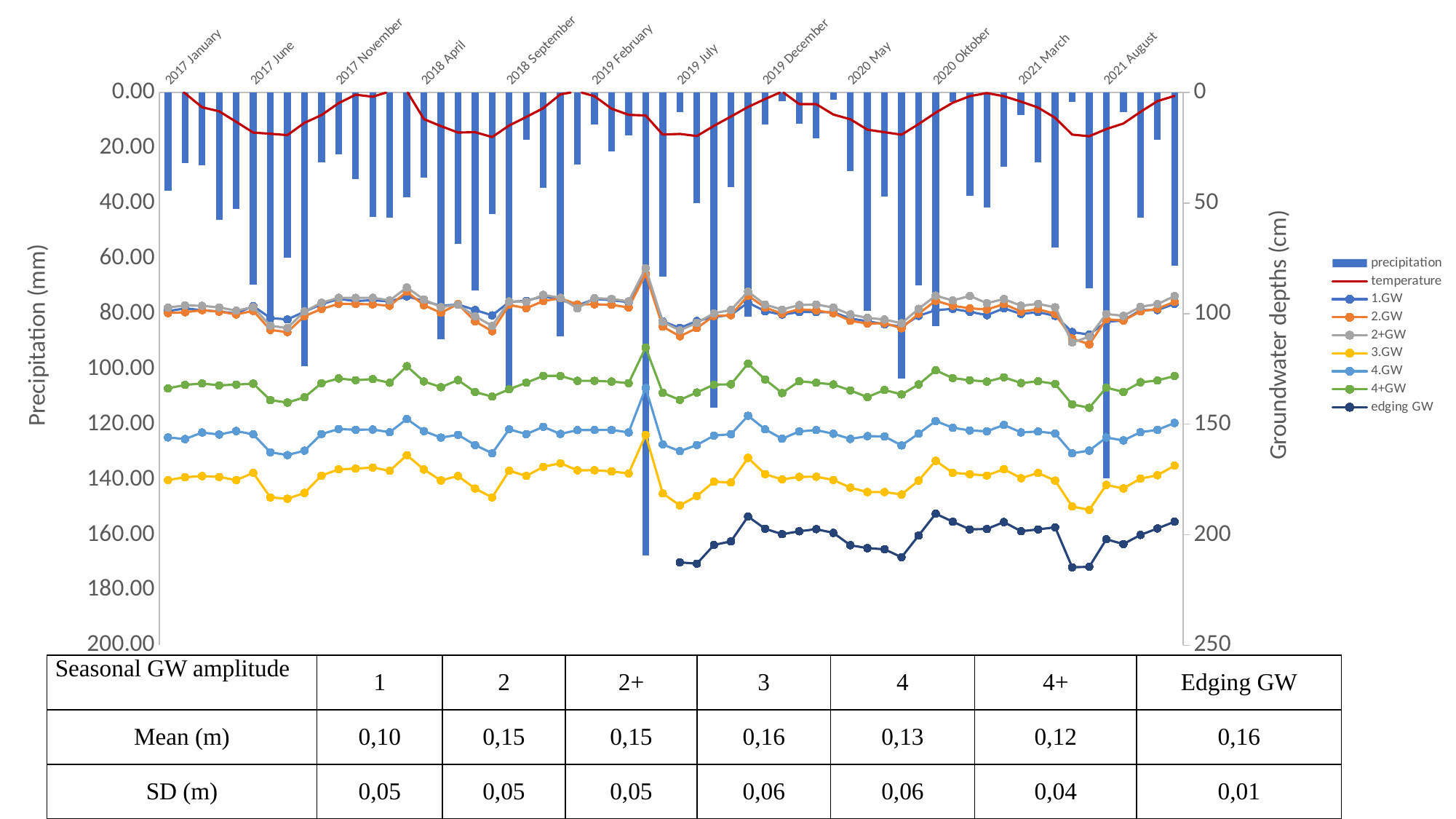
Which groundwater series begins latest along the x axis, with no points before 2019 July? edging GW Which series in the chart is drawn as bars? precipitation Is the groundwater depth for 4+GW at 2017 January greater or less than 100 cm? greater Is the precipitation value for 2017 January greater or less than 20.00 mm? greater Is the tallest precipitation bar greater or less than 140.00 mm? greater How many groundwater (GW) series are plotted as lines in the chart? 7 What kind of chart is shown on the slide? A combined bar and line chart How many series does the chart legend list? 9 What is the title of the right-hand vertical axis of the chart? Groundwater depths (cm) Which series shows a greater groundwater depth, 3.GW or 4.GW? 3.GW Which groundwater series is plotted at the greatest depth (lowest on the chart)? edging GW